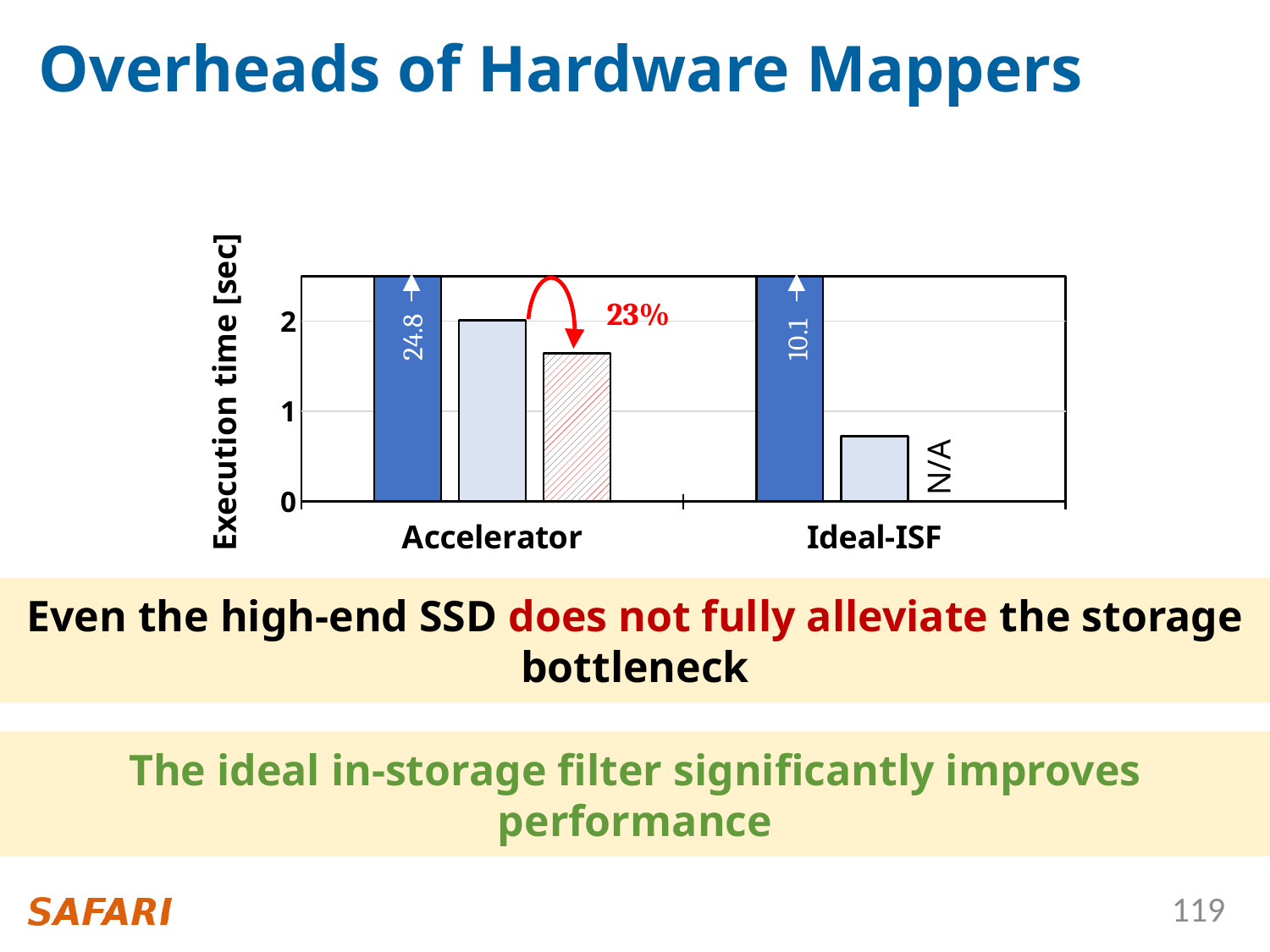
What kind of chart is shown on the slide? bar chart What percentage is written in red next to the arrow above the Accelerator bars? 23% Which category has the larger dark blue bar value, Accelerator or Ideal-ISF? Accelerator What value is labelled on the dark blue bar for Ideal-ISF? 10.1 How many categories are shown on the x axis of the chart? 2 What is the title of the y axis of the chart? Execution time [sec] What is the label shown in place of the third bar for Ideal-ISF? N/A What is the difference between the dark blue bar values for Accelerator (24.8) and Ideal-ISF (10.1)? 14.7 What value is labelled on the dark blue bar for Accelerator? 24.8 Is the value of the light blue bar for Accelerator greater or less than 1? greater Is the value of the light blue bar for Ideal-ISF greater or less than 1? less Is the value of the red hatched bar for Accelerator greater or less than 1? greater